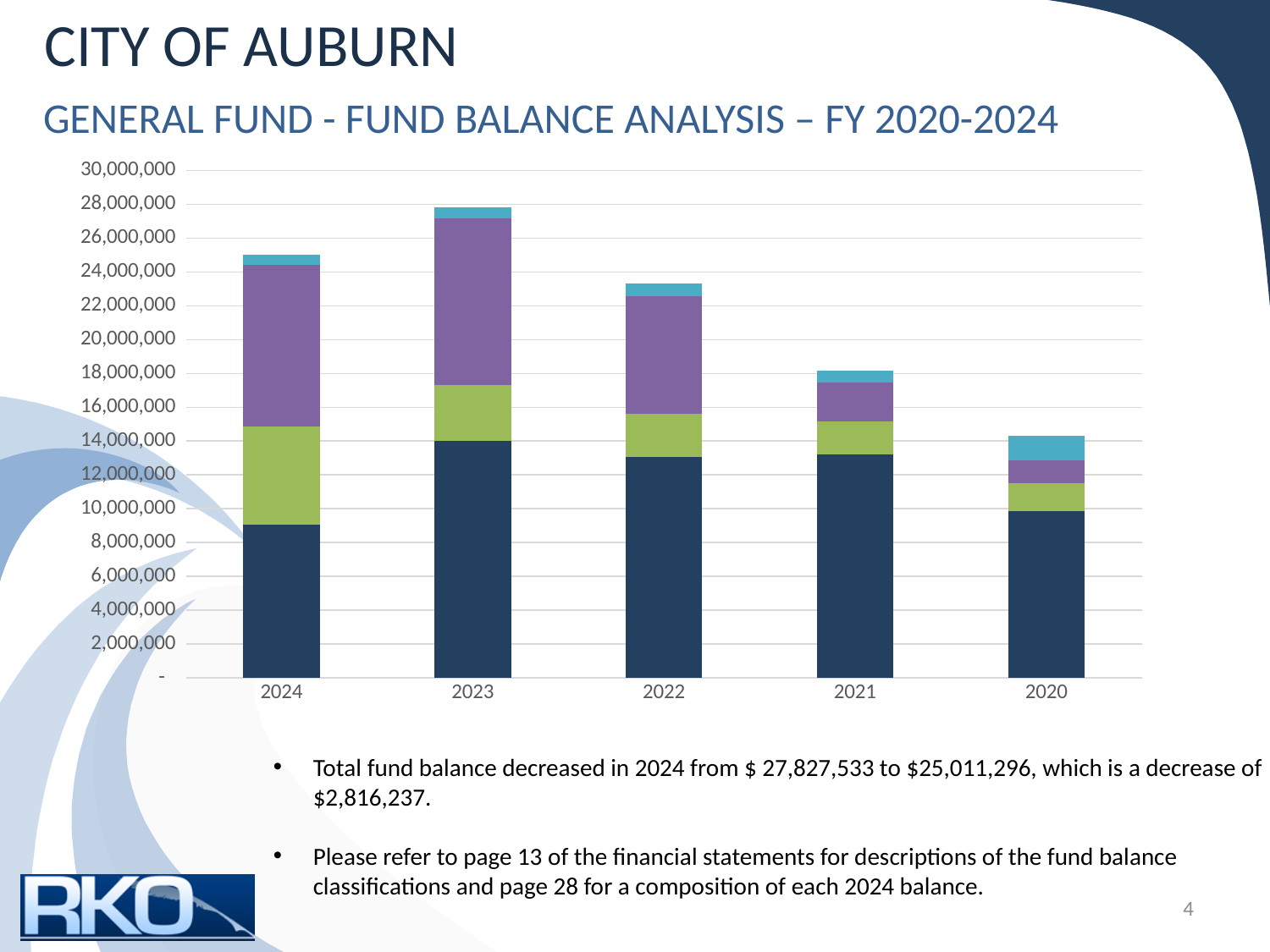
Which bar is taller, 2022 or 2021? 2022 Which year has the tallest stacked bar (highest total fund balance)? 2023 By how much did the total fund balance decrease from 2023 to 2024? $2,816,237 How many coloured segments make up each stacked bar? 4 According to the slide, what was the total fund balance in 2024? $25,011,296 How many years (bars) are shown on the x axis of the chart? 5 According to the slide, what was the total fund balance in 2023? $27,827,533 Is the total of the 2022 bar greater or less than 22,000,000? greater What kind of chart is shown on the slide? Stacked bar chart Is the total of the 2020 bar greater or less than 16,000,000? less Moving from 2023 to 2020 along the x axis, do the bar totals rise or fall? fall Which year has the shortest stacked bar (lowest total fund balance)? 2020